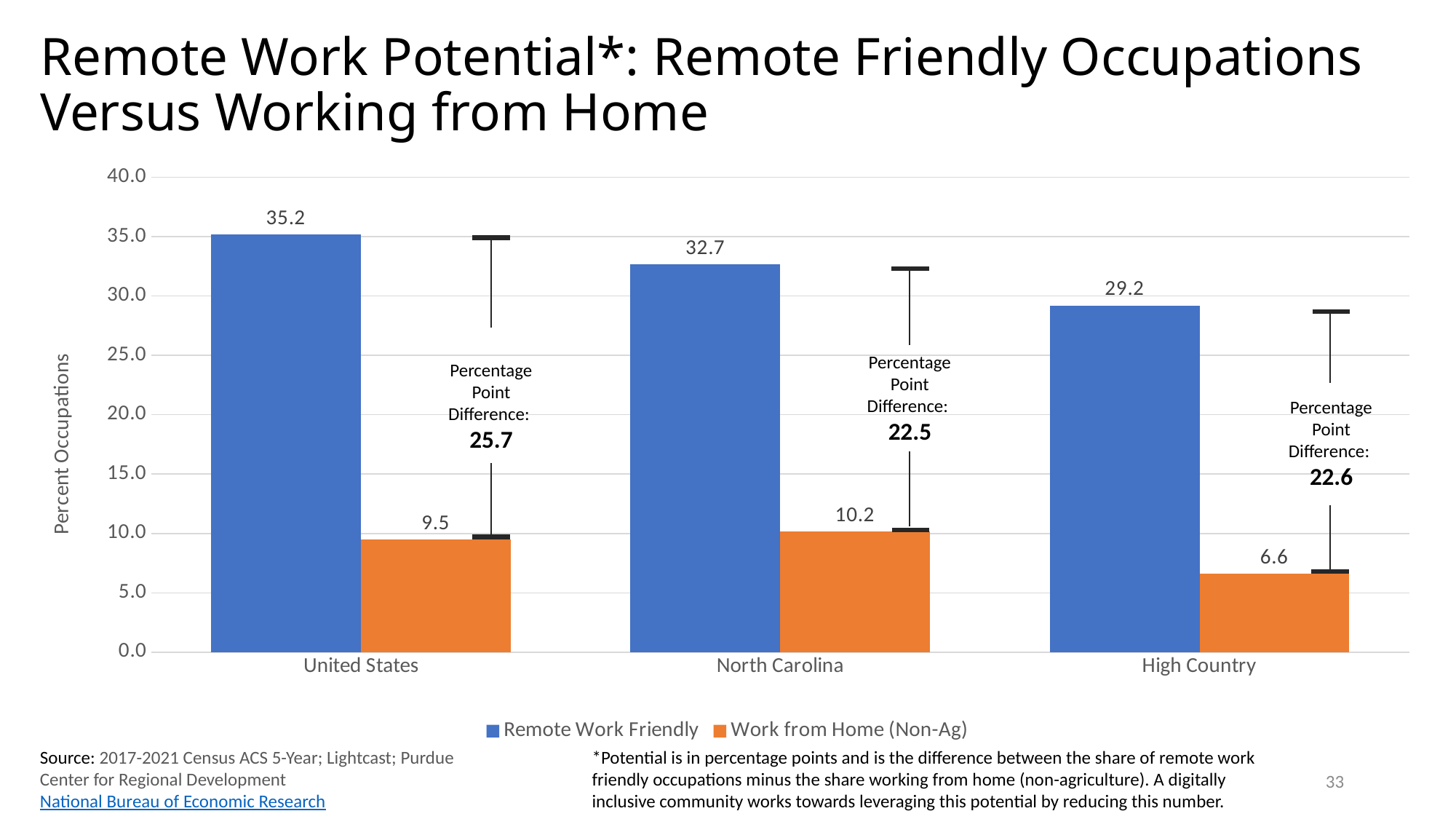
What is the difference between the Remote Work Friendly value and the Work from Home (Non-Ag) value for North Carolina? 22.5 What is the Work from Home (Non-Ag) value for North Carolina? 10.2 Which is larger: the Work from Home (Non-Ag) value for the United States or for North Carolina? North Carolina How many regions are shown on the x axis? 3 What is the Remote Work Friendly value for the United States? 35.2 What is the difference between the Remote Work Friendly values for the United States and High Country? 6.0 What kind of chart is shown on the slide? Bar chart How many series does the legend list? 2 Which region has the highest Remote Work Friendly value? United States What is the Work from Home (Non-Ag) value for High Country? 6.6 Is the Remote Work Friendly value for High Country greater or less than 30.0? less Which region has the lowest Work from Home (Non-Ag) value? High Country